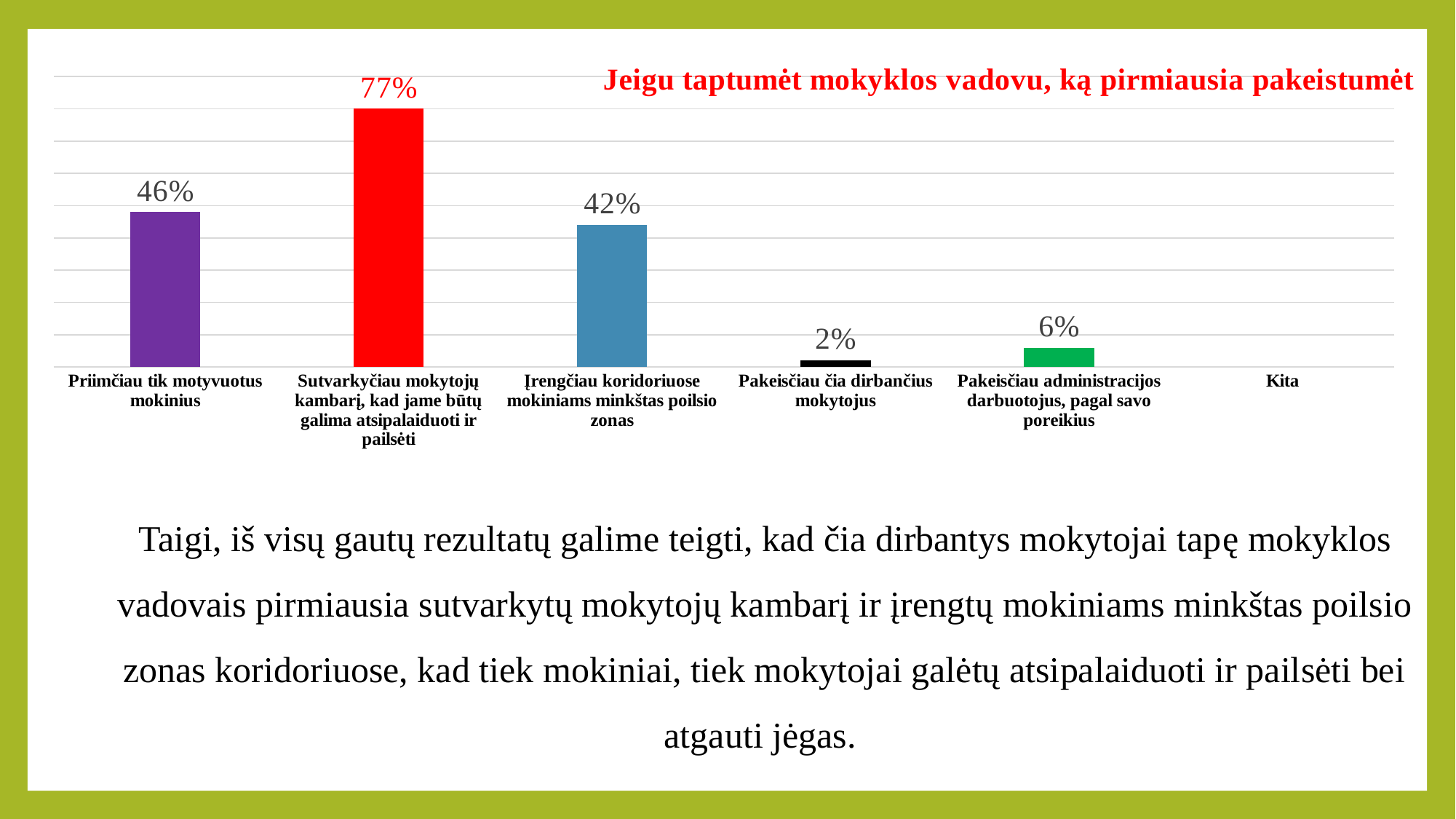
Among the categories with a labelled bar, which has the lowest value? Pakeisčiau čia dirbančius mokytojus What kind of chart is shown on the slide? Bar chart What is the title of the chart? Jeigu taptumėt mokyklos vadovu, ką pirmiausia pakeistumėt What value is shown for "Sutvarkyčiau mokytojų kambarį, kad jame būtų galima atsipalaiduoti ir pailsėti"? 77% What value is shown for "Priimčiau tik motyvuotus mokinius"? 46% What value is shown for "Pakeisčiau administracijos darbuotojus, pagal savo poreikius"? 6% What value is shown for "Pakeisčiau čia dirbančius mokytojus"? 2% What value is shown for "Įrengčiau koridoriuose mokiniams minkštas poilsio zonas"? 42% Which category has the highest value? Sutvarkyčiau mokytojų kambarį, kad jame būtų galima atsipalaiduoti ir pailsėti Which is larger: the value for "Priimčiau tik motyvuotus mokinius" or for "Įrengčiau koridoriuose mokiniams minkštas poilsio zonas"? Priimčiau tik motyvuotus mokinius What is the difference between the values for "Sutvarkyčiau mokytojų kambarį..." and "Priimčiau tik motyvuotus mokinius"? 31% How many categories are labelled on the x axis of the chart? 6